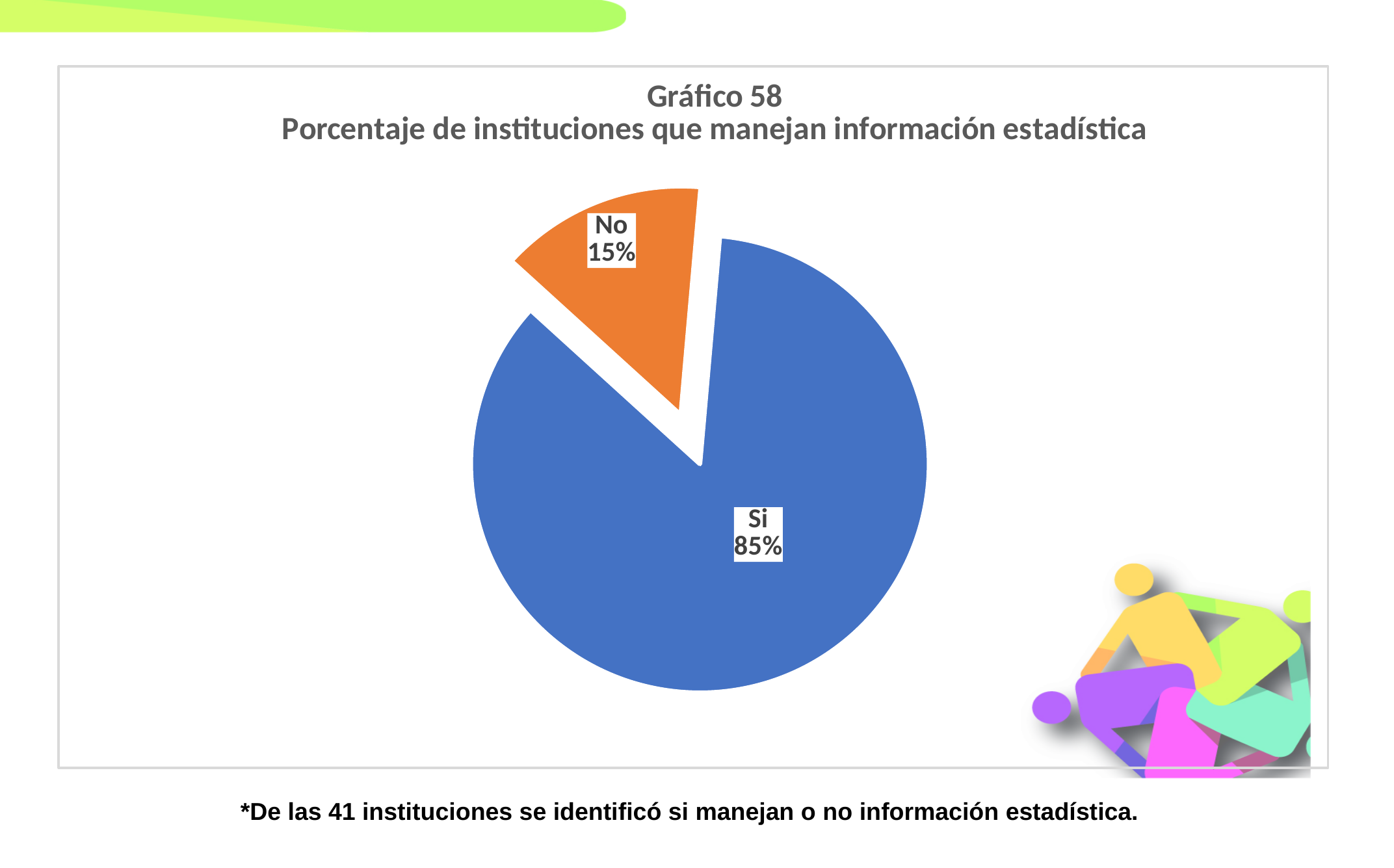
What share of the pie does the "No" slice represent? 15% Is the value for "Si" greater or less than 50%? greater What percentage is shown for the "No" slice? 15% Which slice is the smallest in the pie chart? No Which slice is the largest in the pie chart? Si What colour is the "No" slice? orange What type of chart is shown on the slide? pie chart What is the title of the chart? Gráfico 58 Porcentaje de instituciones que manejan información estadística What is the difference in percentage points between the "Si" and "No" slices? 70 Which slice is larger, "Si" or "No"? Si How many slices does the pie chart have? 2 What percentage is shown for the "Si" slice? 85%